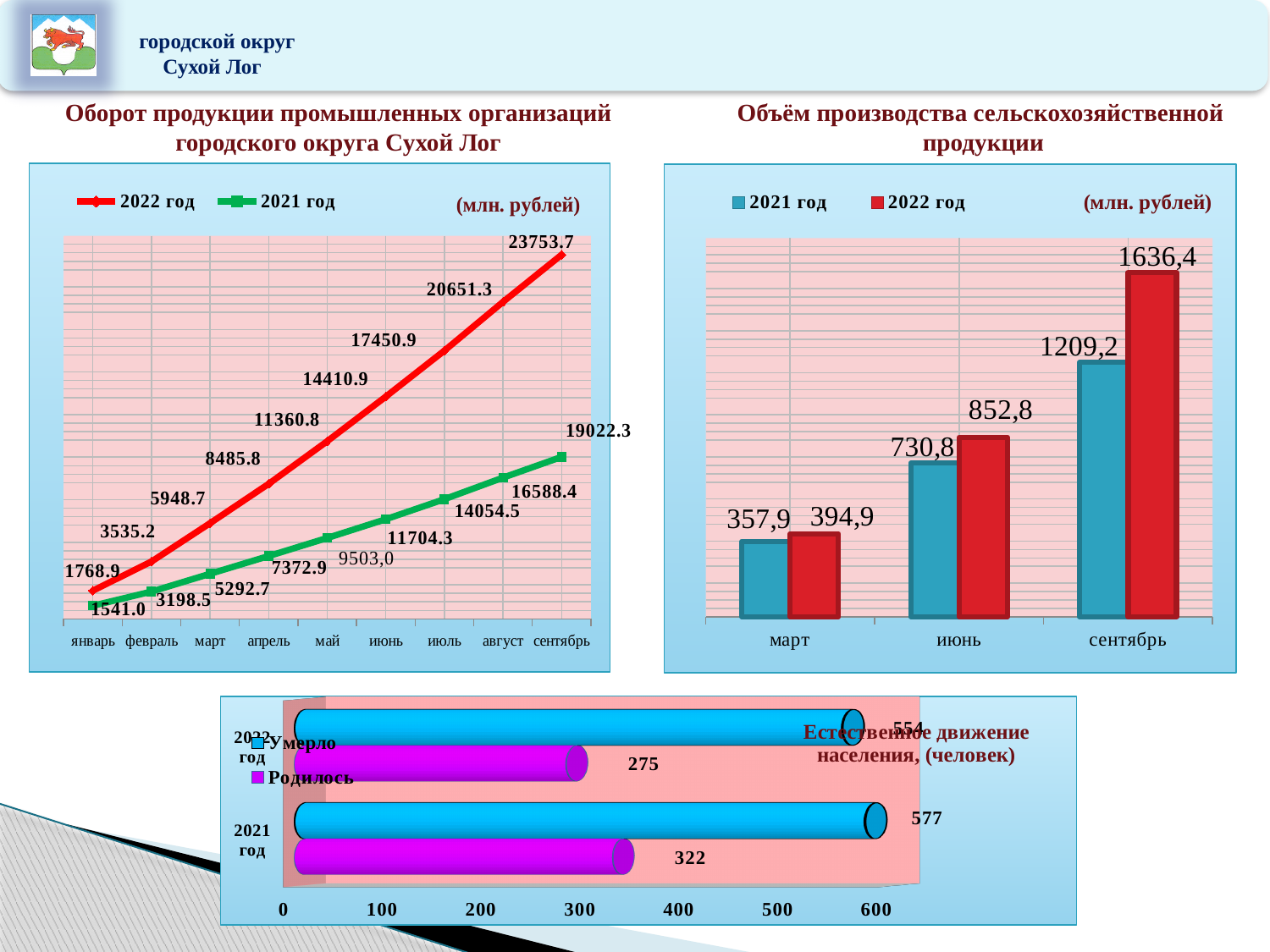
In the chart 'Оборот продукции промышленных организаций городского округа Сухой Лог', how many months are shown on the x axis? 9 In the chart 'Оборот продукции промышленных организаций городского округа Сухой Лог', what is the difference between the 2022 год and 2021 год values in сентябрь? 4731.4 In the chart 'Объём производства сельскохозяйственной продукции', which month has the lowest value for 2021 год? март In the chart 'Оборот продукции промышленных организаций городского округа Сухой Лог', what is the value for 2022 год in сентябрь? 23753.7 In the chart 'Оборот продукции промышленных организаций городского округа Сухой Лог', do the values for 2022 год rise or fall from январь to сентябрь? rise In the chart 'Объём производства сельскохозяйственной продукции', what is the value for 2022 год in сентябрь? 1636,4 What kind of chart is 'Оборот продукции промышленных организаций городского округа Сухой Лог'? line chart In the chart 'Естественное движение населения, (человек)', which is larger: Умерло in 2021 год or Умерло in 2022 год? Умерло in 2021 год In the chart 'Объём производства сельскохозяйственной продукции', how many series does the legend list? 2 In the chart 'Оборот продукции промышленных организаций городского округа Сухой Лог', what is the value for 2021 год in май? 9503,0 In the chart 'Естественное движение населения, (человек)', what is the value for Родилось in 2021 год? 322 In the chart 'Объём производства сельскохозяйственной продукции', what is the value for 2021 год in июнь? 730,8